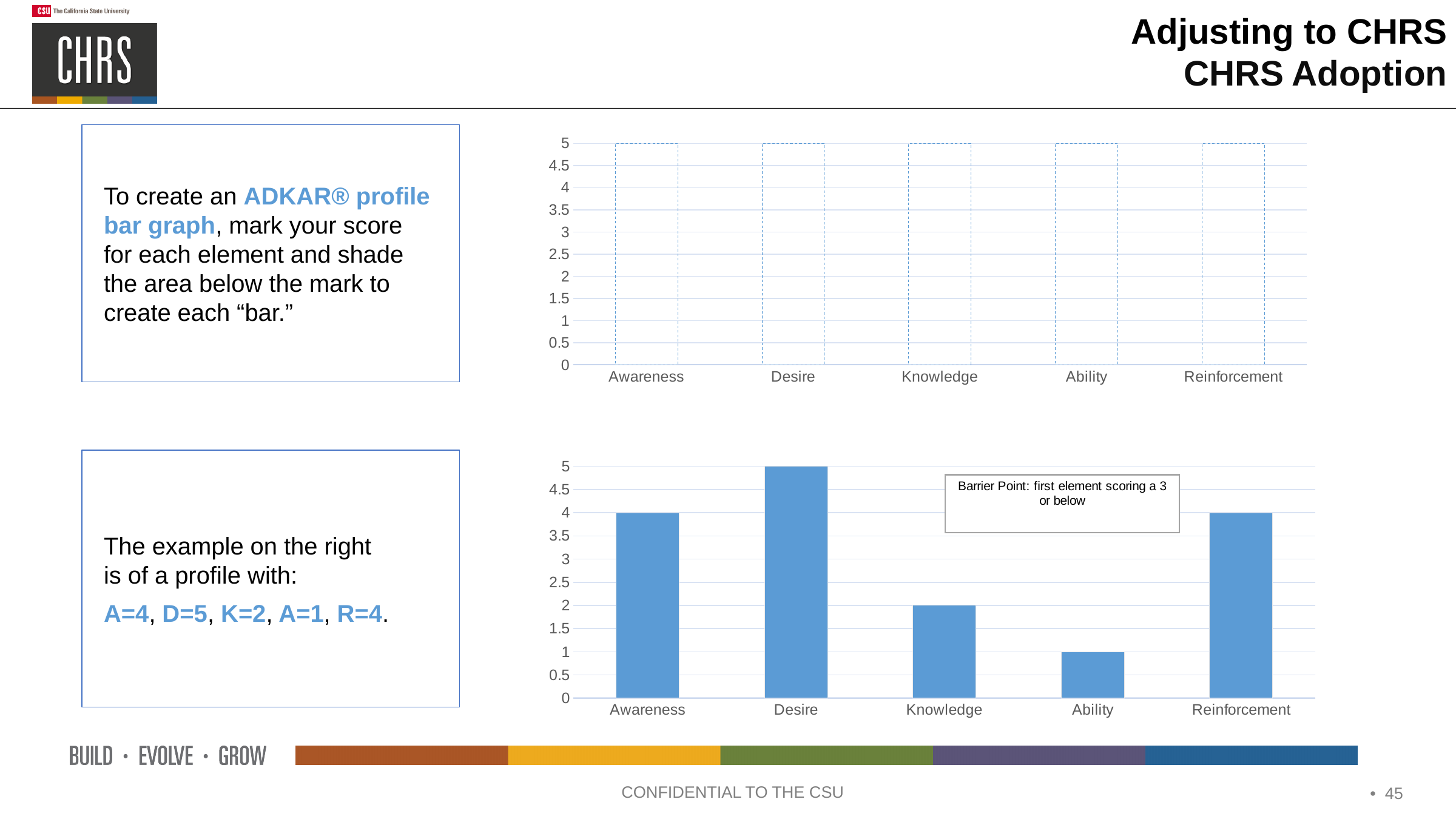
How many categories are shown on the x axis of the bottom chart? 5 In the bottom chart, what is the value for Ability? 1 In the bottom chart, what is the total of the values for Awareness and Reinforcement? 8 What kind of chart is the bottom chart? bar chart In the bottom chart, what is the difference between the values for Desire and Ability? 4 In the bottom chart, which category has the highest value? Desire In the bottom chart, is the value for Reinforcement greater or less than 3? greater In the bottom chart, what is the value for Desire? 5 What does the text box inside the bottom chart say? Barrier Point: first element scoring a 3 or below In the bottom chart, what is the value for Knowledge? 2 In the bottom chart, which category has the lowest value? Ability In the bottom chart, which is larger, the value for Awareness or the value for Knowledge? Awareness